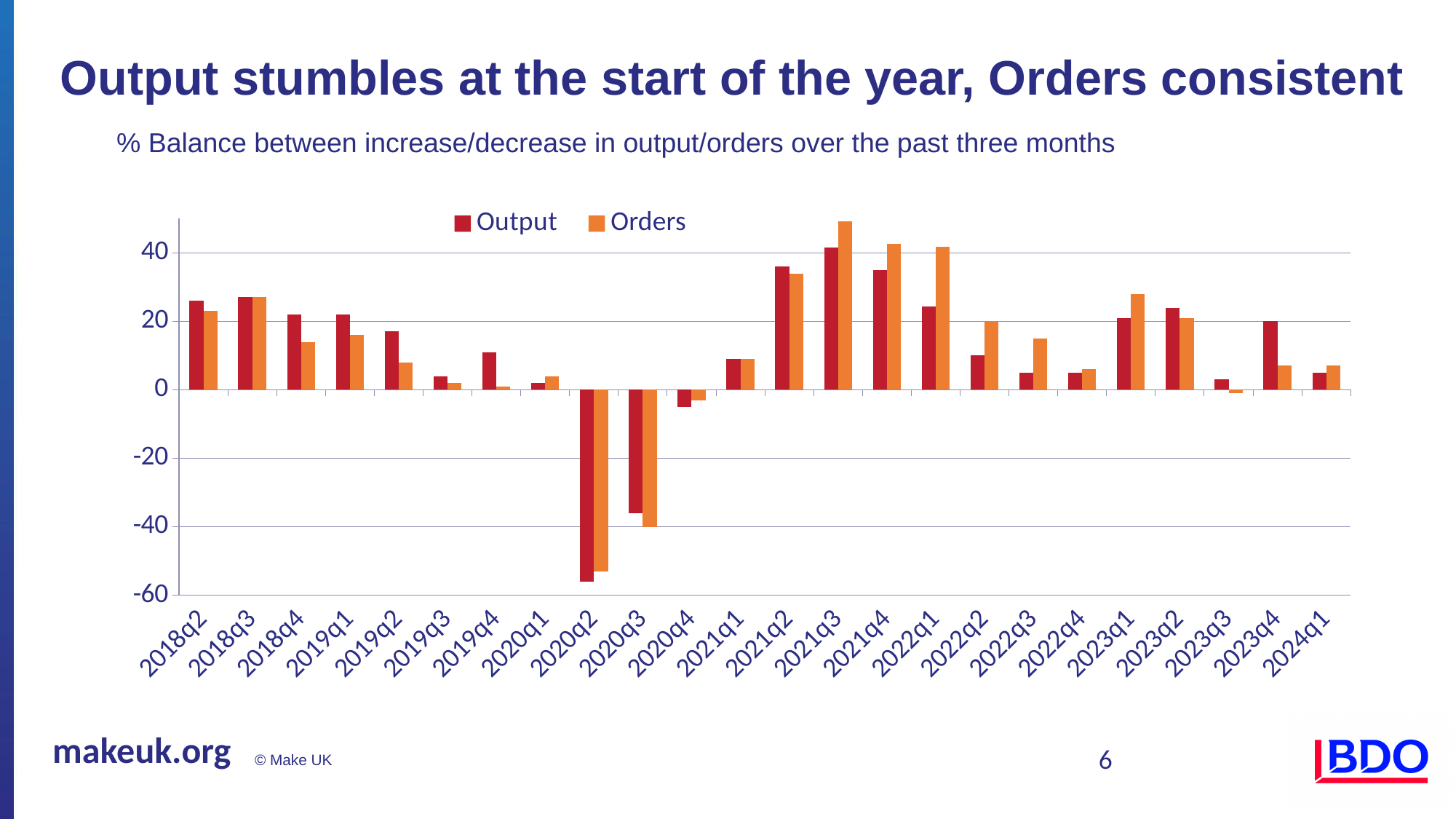
Does the Output value rise or fall from 2018q2 to 2019q3? fall Is the Orders value for 2023q1 greater or less than 20? greater In which quarter is the Output value highest? 2021q3 How many quarters are shown on the x axis? 24 In which quarter is the Output value lowest? 2020q2 What type of chart is shown on the slide? bar chart Is the Output value for 2020q2 greater or less than -40? less Is the Orders value for 2021q3 greater or less than 40? greater In 2018q4, which is larger, Output or Orders? Output How many series does the legend list? 2 In which quarter is the Orders value highest? 2021q3 In 2021q3, which is larger, Output or Orders? Orders